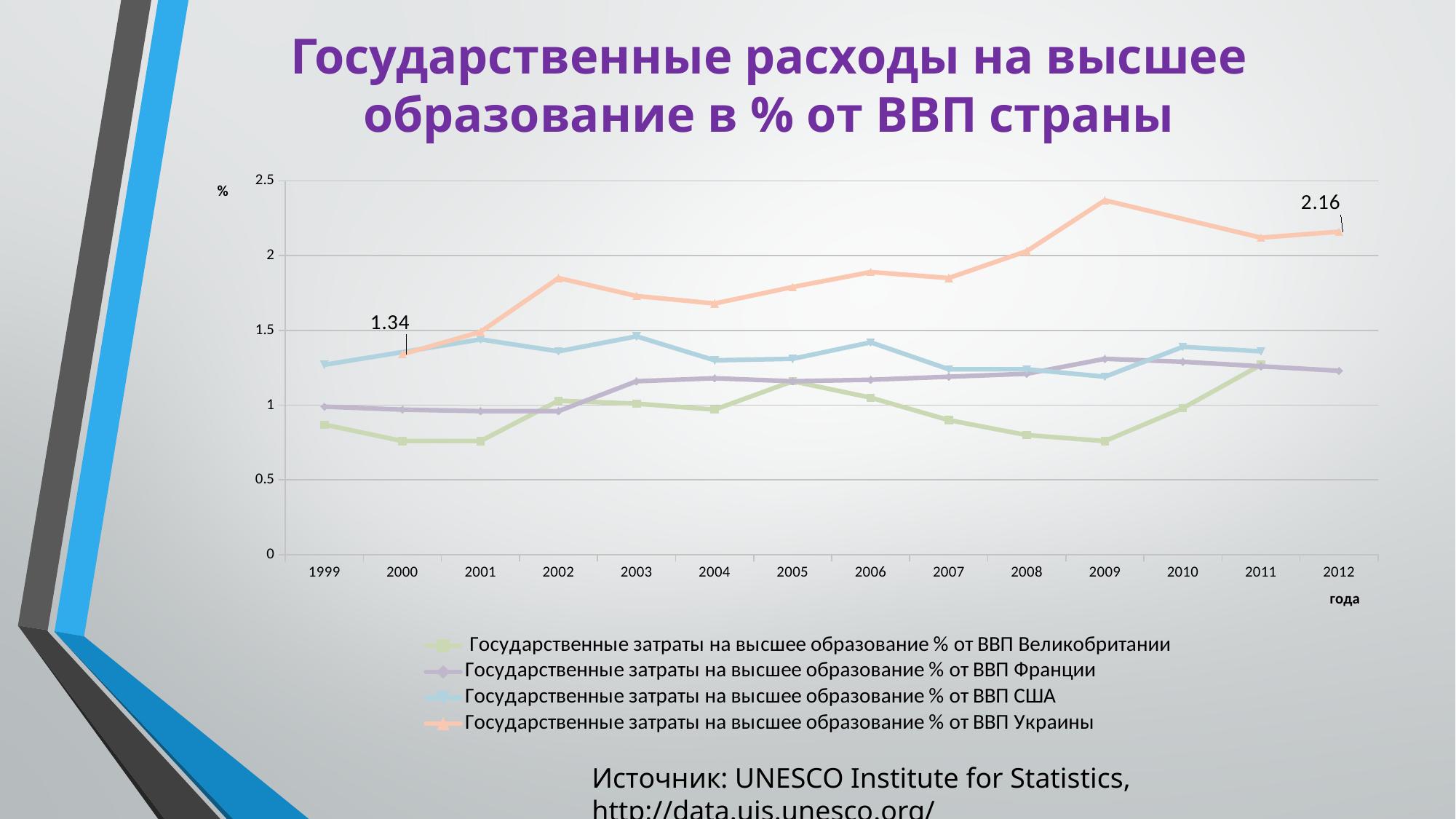
What is the value for Ukraine (Украины) in 2012? 2.16 By how much did the value for Ukraine (Украины) change between 2000 and 2012? 0.82 In which year does the Ukraine (Украины) line reach its highest point? 2009 How many years are shown along the x axis? 14 Is the value for the United Kingdom (Великобритании) in 2000 greater or less than 1? less How many series does the legend list? 4 What kind of chart is shown on the slide? line chart Is the value for Ukraine (Украины) in 2009 greater or less than 2? greater Which country has the highest value in 2012? Украины (Ukraine) Which country has the lowest value in 2009? Великобритании (United Kingdom) Which is larger in 2003: the value for the USA (США) or for France (Франции)? США (USA) What is the value for Ukraine (Украины) in 2000? 1.34